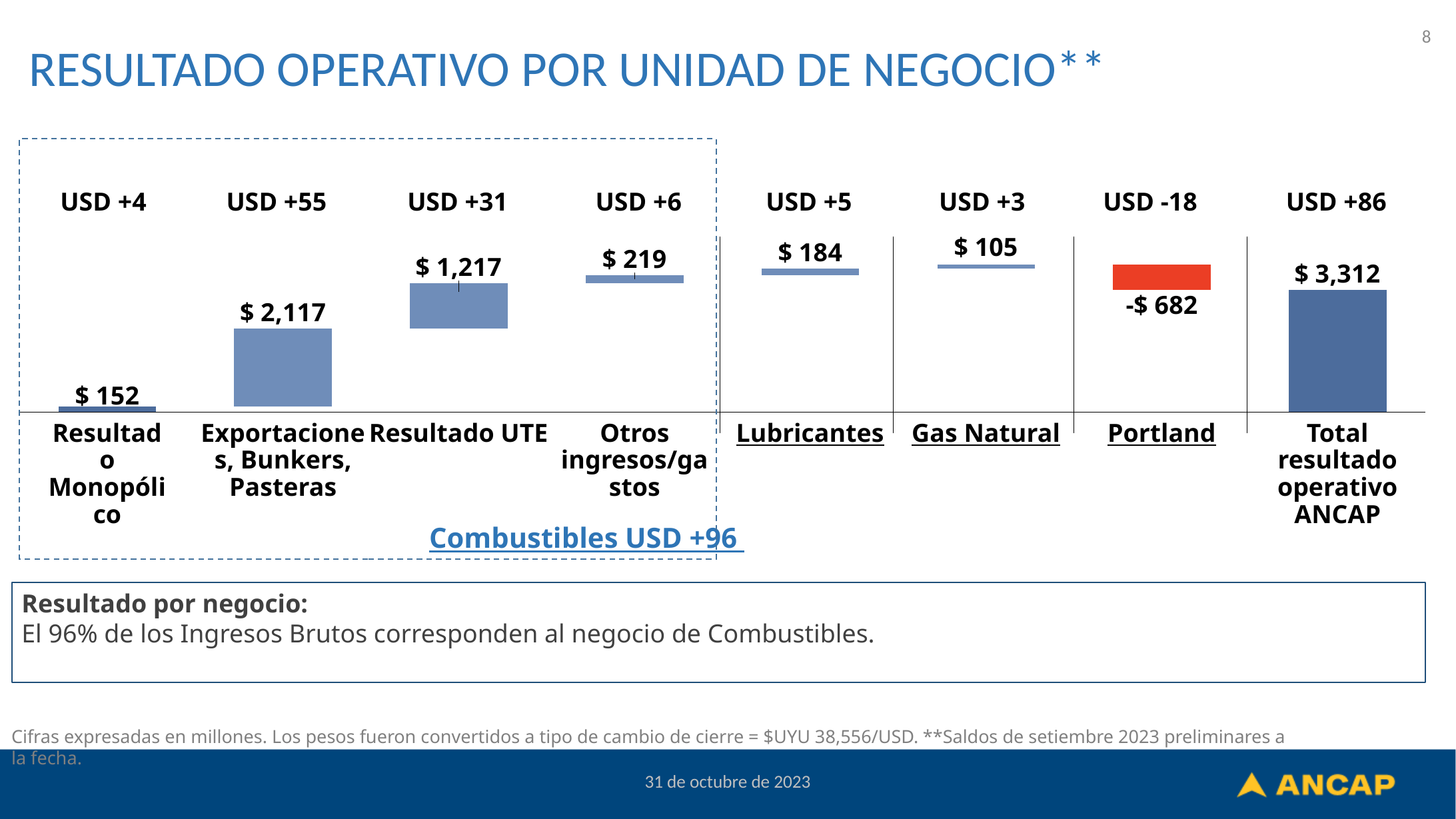
What kind of chart is shown on the slide? Bar chart (waterfall) Which business unit has the lowest (most negative) value? Portland What USD figure is shown above the Lubricantes bar? USD +5 What is the value shown for Portland? -$ 682 Excluding the total bar, which category has the highest value? Exportaciones, Bunkers, Pasteras What is the value shown for Total resultado operativo ANCAP? $ 3,312 Which is larger, the value for Resultado Monopólico or the value for Otros ingresos/gastos? Otros ingresos/gastos What is the value shown for Resultado UTE? $ 1,217 What is the difference between the values for Lubricantes and Gas Natural? $ 79 What is the value shown for Exportaciones, Bunkers, Pasteras? $ 2,117 What USD figure is shown for the Combustibles group in the dashed box? Combustibles USD +96 How many bars are plotted in the chart, including the total bar? 8